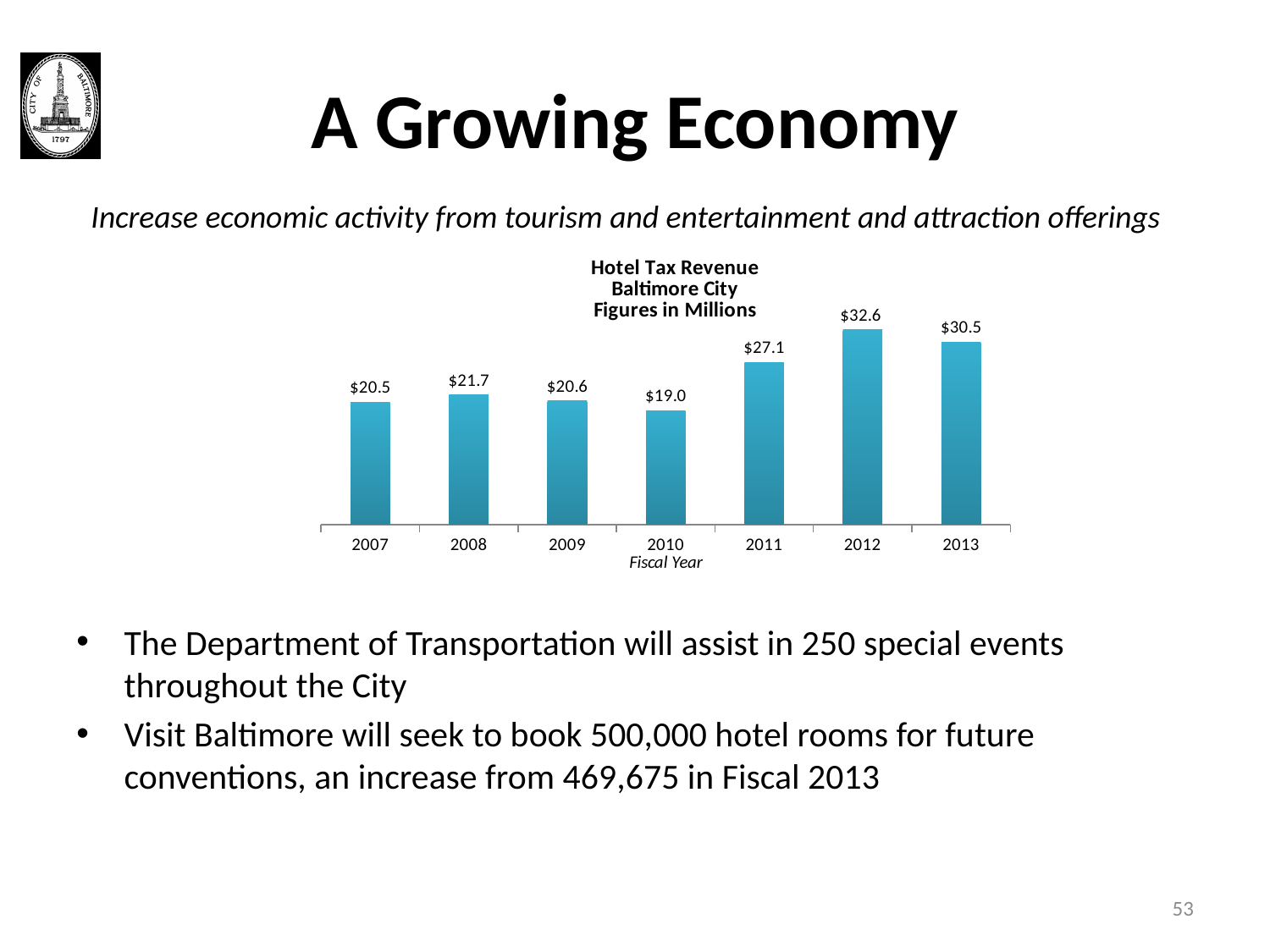
What was the hotel tax revenue for fiscal year 2012? $32.6 What is the difference in hotel tax revenue between fiscal years 2012 and 2013? $2.1 What is the difference in hotel tax revenue between fiscal years 2011 and 2010? $8.1 What was the hotel tax revenue for fiscal year 2010? $19.0 In what units are the figures in the chart expressed, according to the chart title? Millions What is the label on the x axis of the chart? Fiscal Year Which fiscal year had higher hotel tax revenue, 2011 or 2013? 2013 Which fiscal year had the highest hotel tax revenue? 2012 Which fiscal year had the lowest hotel tax revenue? 2010 What was the hotel tax revenue for fiscal year 2008? $21.7 What type of chart is used to show hotel tax revenue? Bar chart How many fiscal years are shown in the chart? 7